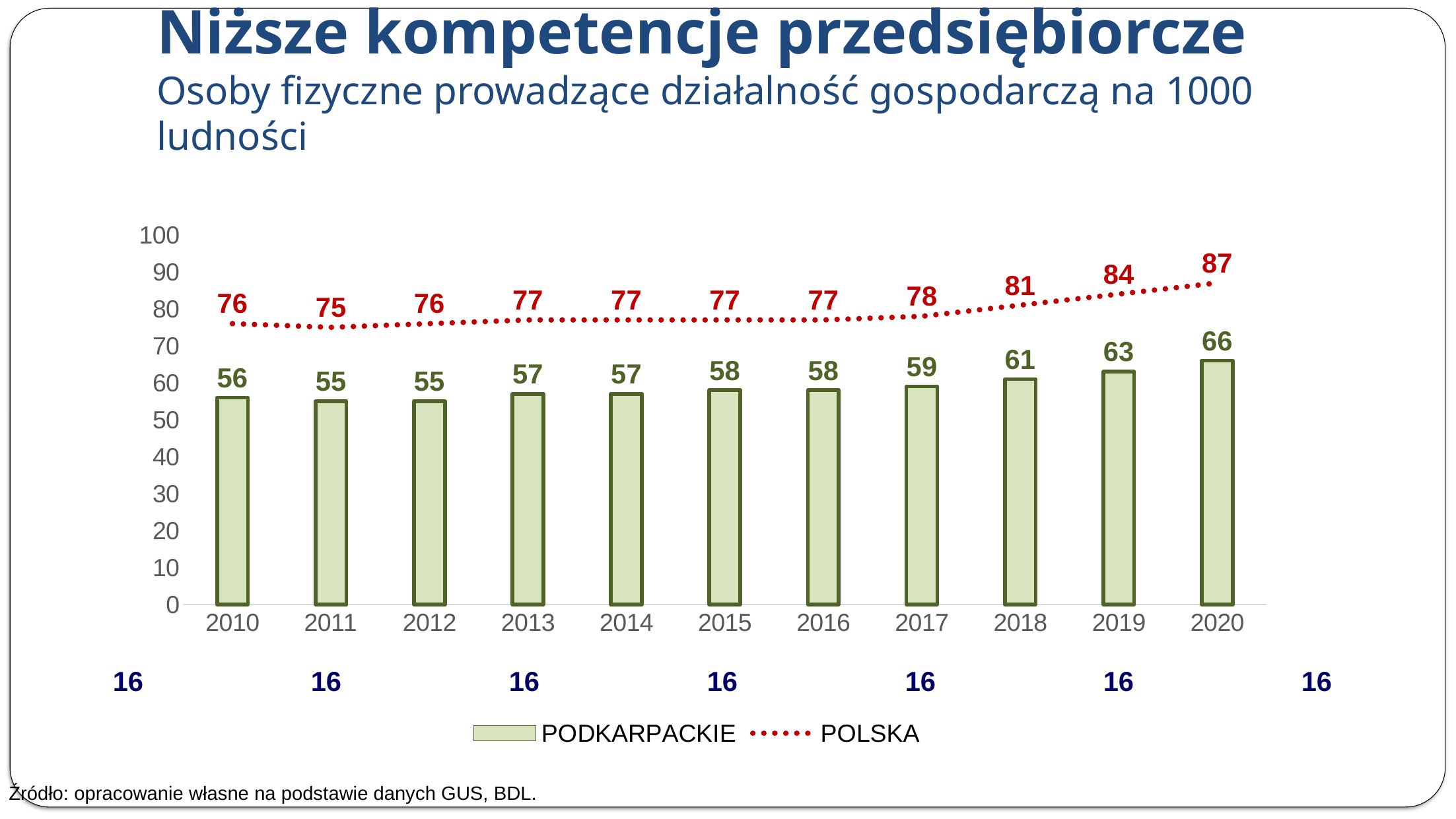
How many series does the legend list? 2 What is the difference between the PODKARPACKIE values in 2020 and 2010? 10 In which year is the POLSKA value highest? 2020 How many years are shown on the x axis? 11 What is the value for PODKARPACKIE in 2020? 66 What is the difference between the POLSKA and PODKARPACKIE values in 2020? 21 What is the value for POLSKA in 2018? 81 Does the POLSKA series rise or fall from 2017 to 2020? rise Which is larger in 2015: the POLSKA value or the PODKARPACKIE value? POLSKA What is the value for PODKARPACKIE in 2011? 55 In which year is the PODKARPACKIE value lowest? 2011 and 2012 What kind of chart is used for the PODKARPACKIE series? bar chart